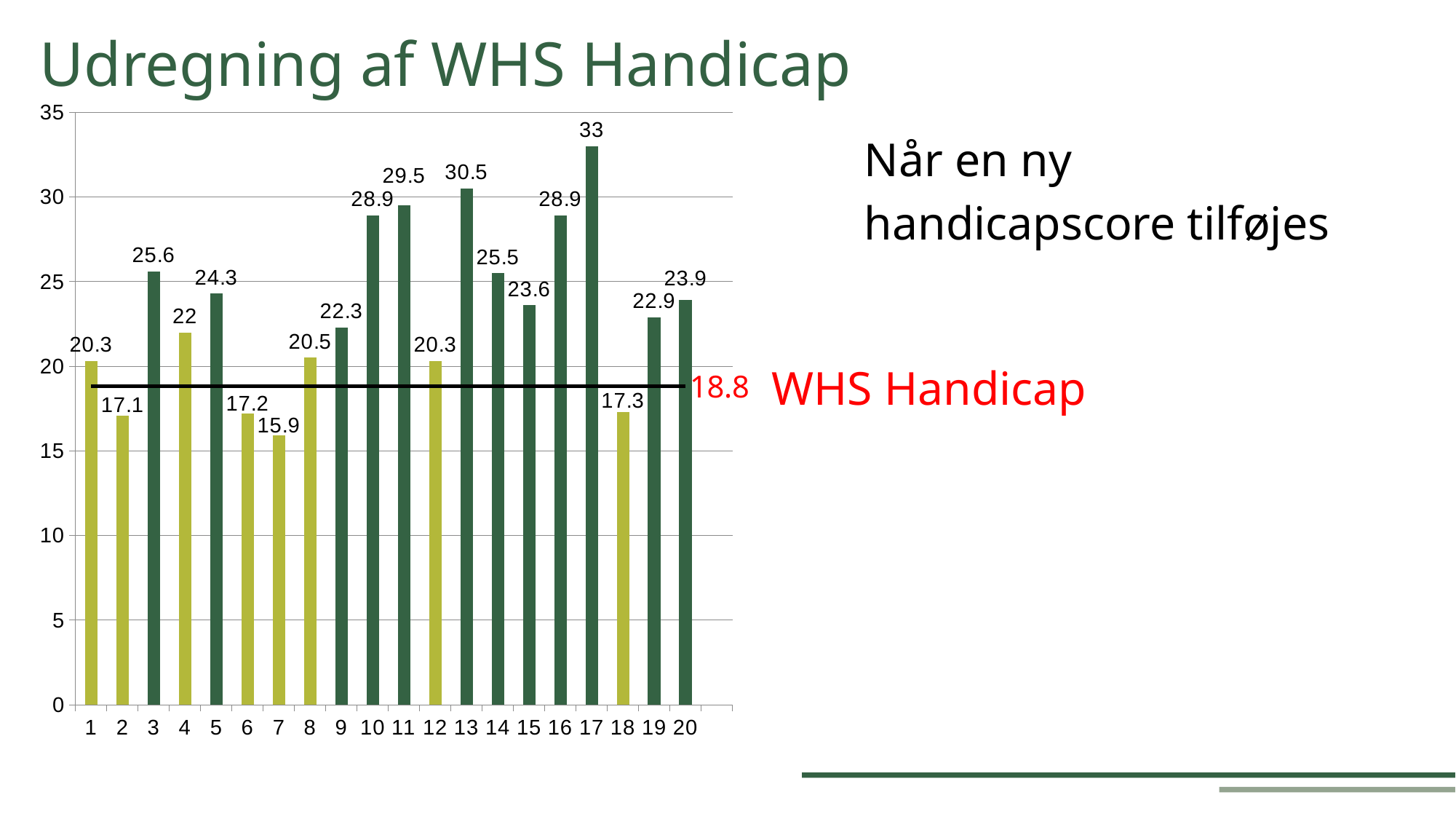
What kind of chart is shown on the slide? bar chart What is the difference between the values for category 13 and category 4? 8.5 What is the value for category 7? 15.9 Which category has the highest value? 17 Which category has the lowest value? 7 How many bars are drawn in the lighter green colour? 8 What is the value for category 17? 33 How many categories are shown on the x axis? 20 What value is marked by the horizontal line labelled WHS Handicap? 18.8 Which is larger, the value for category 5 or the value for category 15? category 5 What is the difference between the values for category 17 and category 7? 17.1 What is the value for category 11? 29.5